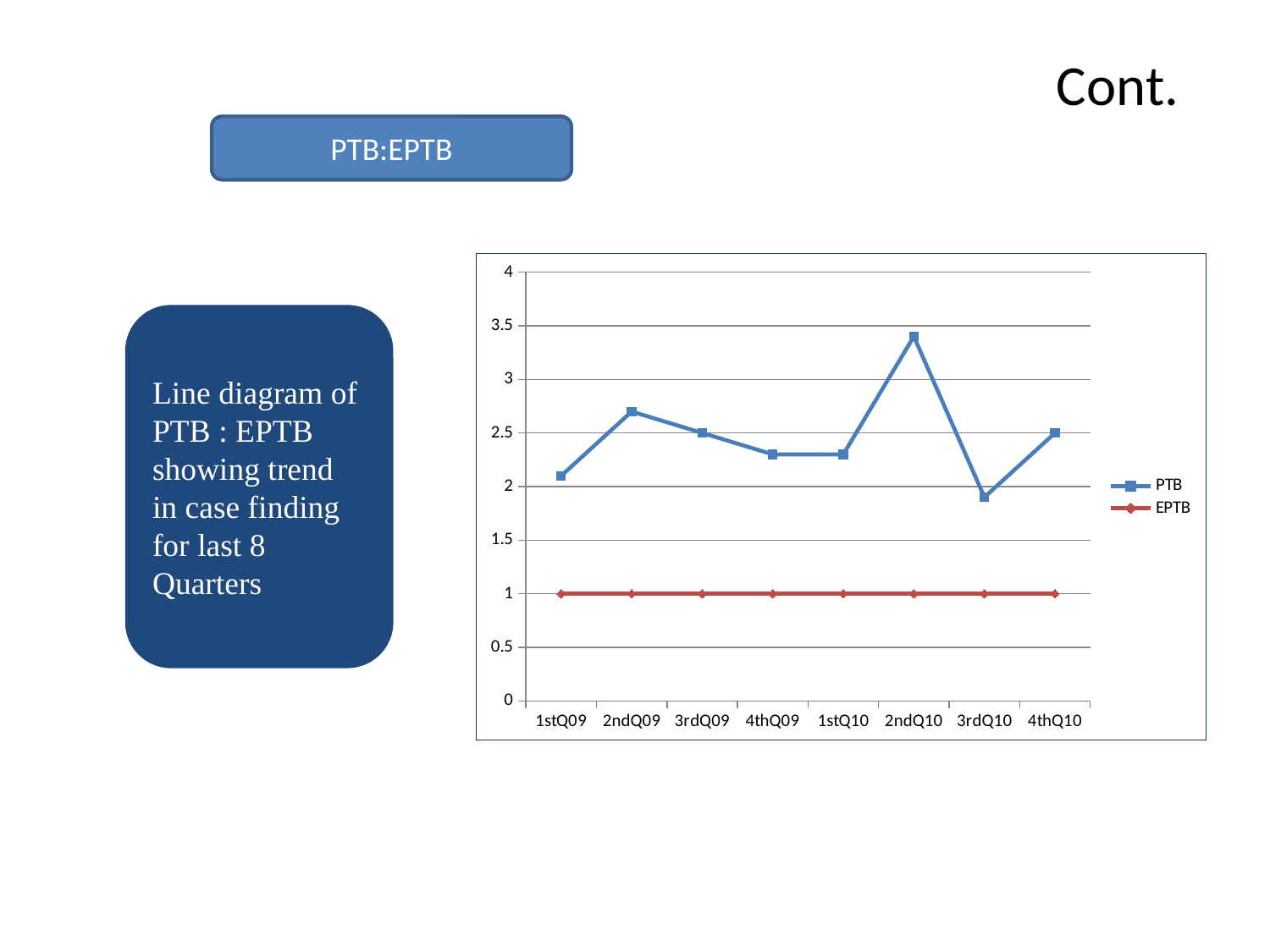
What is the value of EPTB at 4thQ10? 1 How many quarters are plotted along the x axis? 8 In which quarter is the PTB value highest? 2ndQ10 What kind of chart is shown on the slide? Line chart Is the PTB value for 3rdQ10 greater or less than 2? less Is the PTB value for 2ndQ10 greater or less than 3? greater Does the PTB line rise or fall from 2ndQ09 to 4thQ09? fall Which series is drawn in red in the chart? EPTB Which quarter has the larger PTB value, 2ndQ09 or 4thQ09? 2ndQ09 In which quarter is the PTB value lowest? 3rdQ10 How many series does the legend list? 2 What is the value of EPTB at 1stQ09? 1